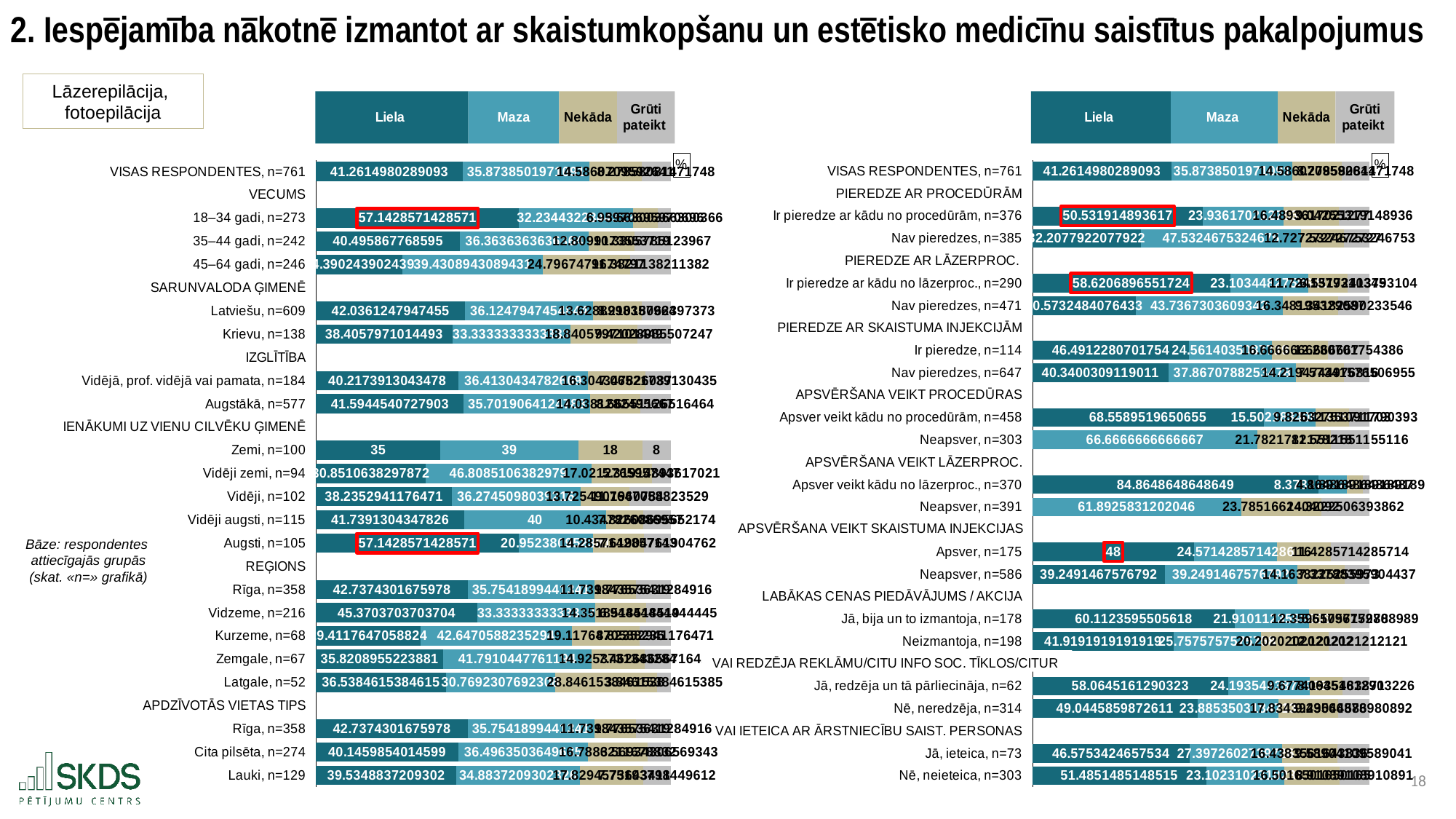
In the left chart, what is the 'Liela' value for 'Augsti, n=105'? 57.1428571428571 In the right chart, what is the 'Liela' value for 'Ir pieredze ar kādu no lāzerproc., n=290'? 58.6206896551724 In the left chart, which group has the larger 'Liela' value: '18–34 gadi, n=273' or '35–44 gadi, n=242'? 18–34 gadi, n=273 In the left chart, what is the 'Grūti pateikt' value for 'Zemi, n=100'? 8 In the left chart, what is the 'Maza' value for 'Vidēji augsti, n=115'? 40 In the left chart, what is the total of the stacked bar for 'Zemi, n=100'? 100 In the right chart, which group has the highest 'Liela' value? Apsver veikt kādu no lāzerproc., n=370 What kind of chart is shown on the left of the slide? Stacked bar chart In the right chart, what is the 'Liela' value for 'Apsver, n=175'? 48 How many series does the legend of the left chart list? 4 In the left chart, what is the 'Liela' value for 'Zemi, n=100'? 35 In the left chart, what is the difference between the 'Maza' and 'Nekāda' values for 'Zemi, n=100'? 21